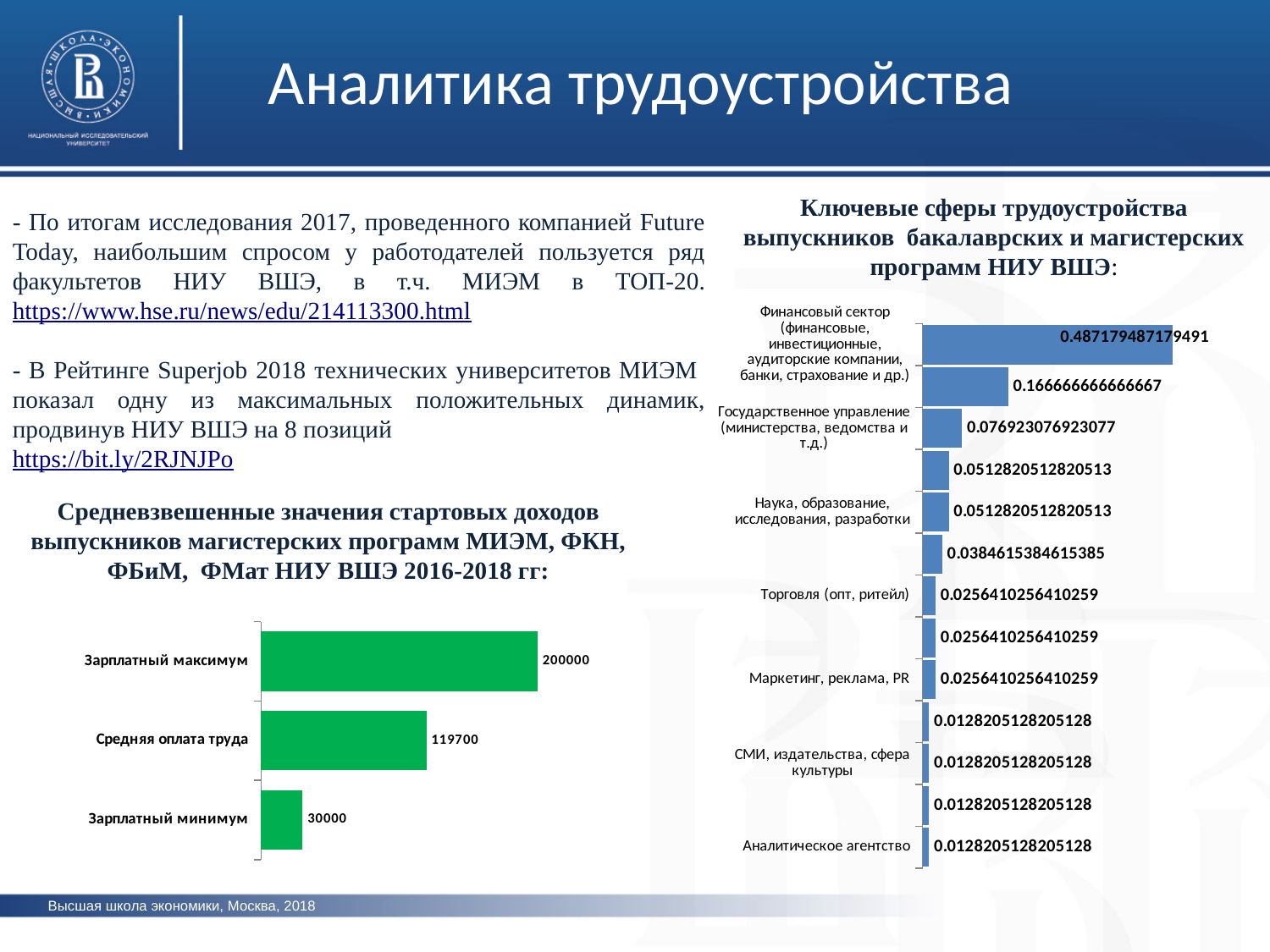
In the left chart on starting incomes, what is the difference between "Зарплатный максимум" and "Средняя оплата труда"? 80300 What type of chart is the left chart on starting incomes? Bar chart In the chart titled "Средневзвешенные значения стартовых доходов..." on the left, what is the value for "Зарплатный максимум"? 200000 In the left chart on starting incomes, what is the difference between "Зарплатный максимум" and "Зарплатный минимум"? 170000 In the right chart on key employment sectors, how many bars are plotted? 13 In the right chart on key employment sectors, which category has the highest value? Финансовый сектор In the right chart on key employment sectors, what is the value for "Государственное управление (министерства, ведомства и т.д.)"? 0.076923076923077 In the left chart on starting incomes, what is the value for "Зарплатный минимум"? 30000 In the right chart titled "Ключевые сферы трудоустройства...", what is the value for "Финансовый сектор"? 0.487179487179491 In the left chart on starting incomes, how many categories are plotted? 3 In the right chart on key employment sectors, which is larger: "Наука, образование, исследования, разработки" or "Торговля (опт, ритейл)"? Наука, образование, исследования, разработки In the left chart on starting incomes, what is the value for "Средняя оплата труда"? 119700